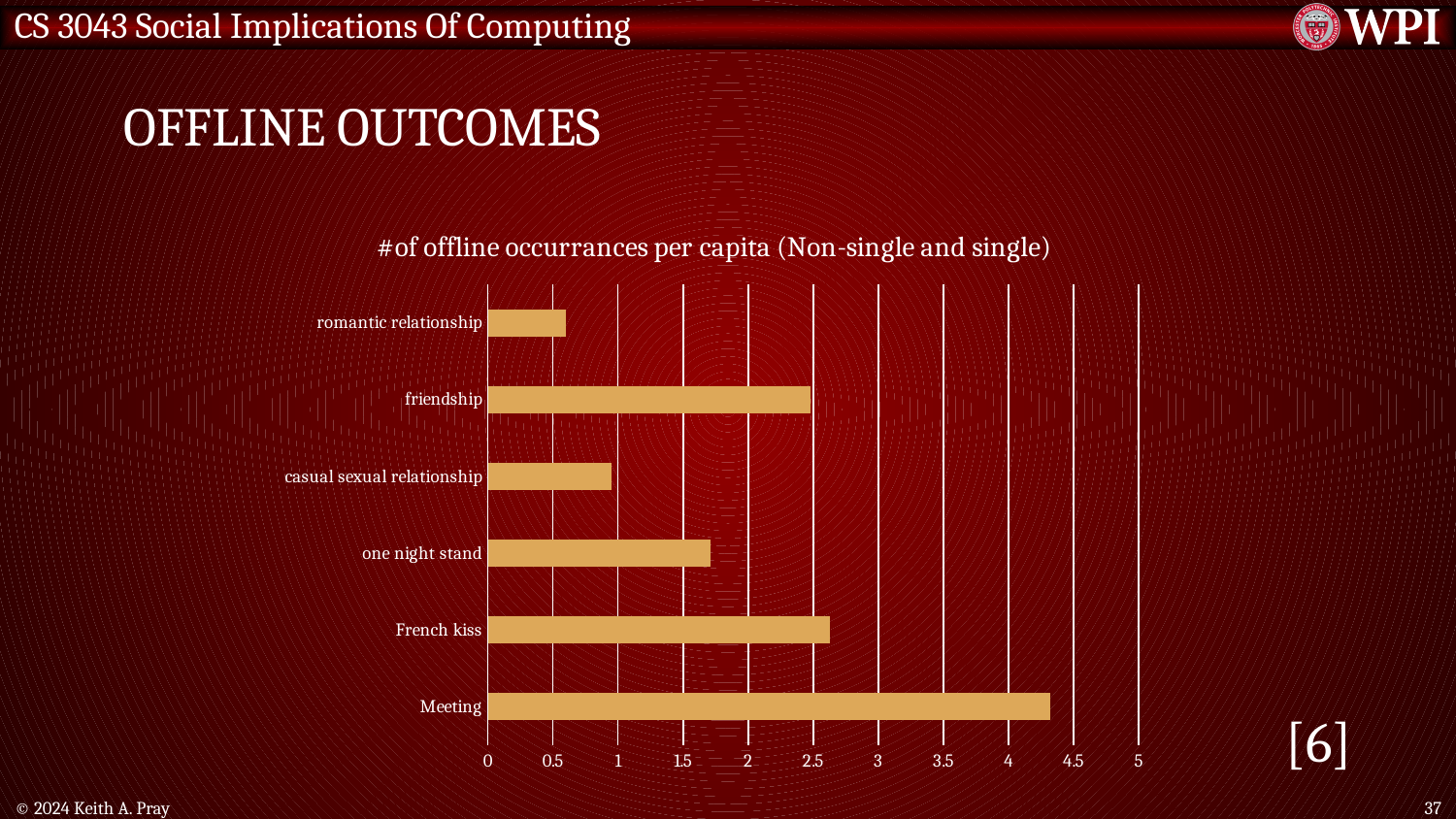
Is the value for friendship greater or less than 2? greater Which category has the lowest value in the chart? romantic relationship Which category has the highest value in the chart? Meeting Is the value for one night stand greater or less than 1.5? greater Which is larger, the value for one night stand or the value for casual sexual relationship? one night stand How many categories are plotted in the chart? 6 Is the value for Meeting greater or less than 4? greater What is the title of the chart? #of offline occurrances per capita (Non-single and single) Which is larger, the value for Meeting or the value for French kiss? Meeting What kind of chart is shown on the slide? bar chart